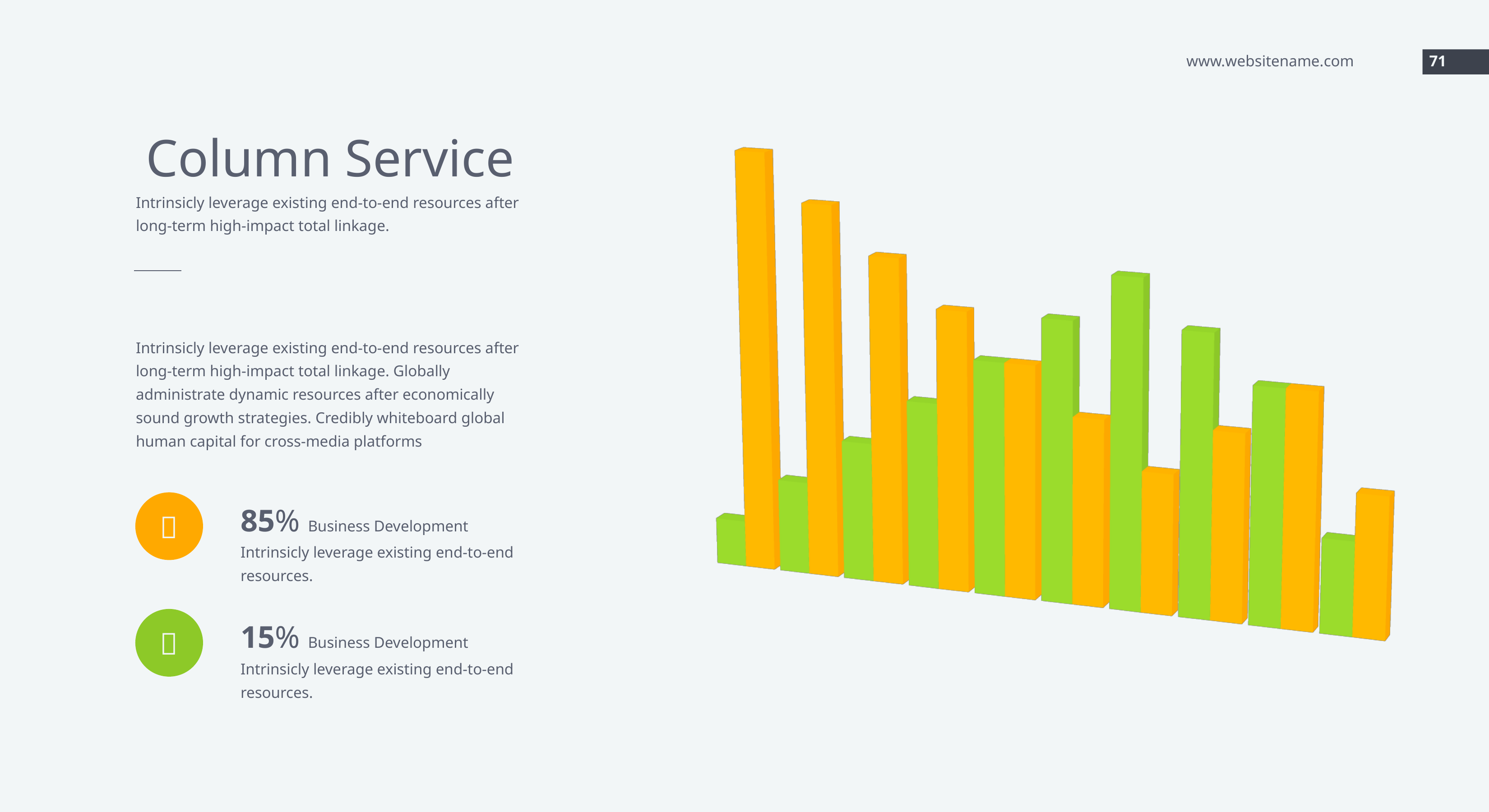
How many data series (bar colours) does the chart show? 2 What kind of chart is shown on the slide? bar chart Which green bar is the tallest in the chart? the seventh green bar from the left What two colours are the bars in the chart? orange and green Does the chart have a legend? No In the first (leftmost) pair of bars, which is taller, the orange bar or the green bar? the orange bar In the seventh pair of bars from the left, which is taller, the orange bar or the green bar? the green bar How many pairs of bars (categories) does the chart show? 10 Which orange bar is the tallest in the chart? the leftmost (first) orange bar Which green bar is the shortest in the chart? the leftmost (first) green bar